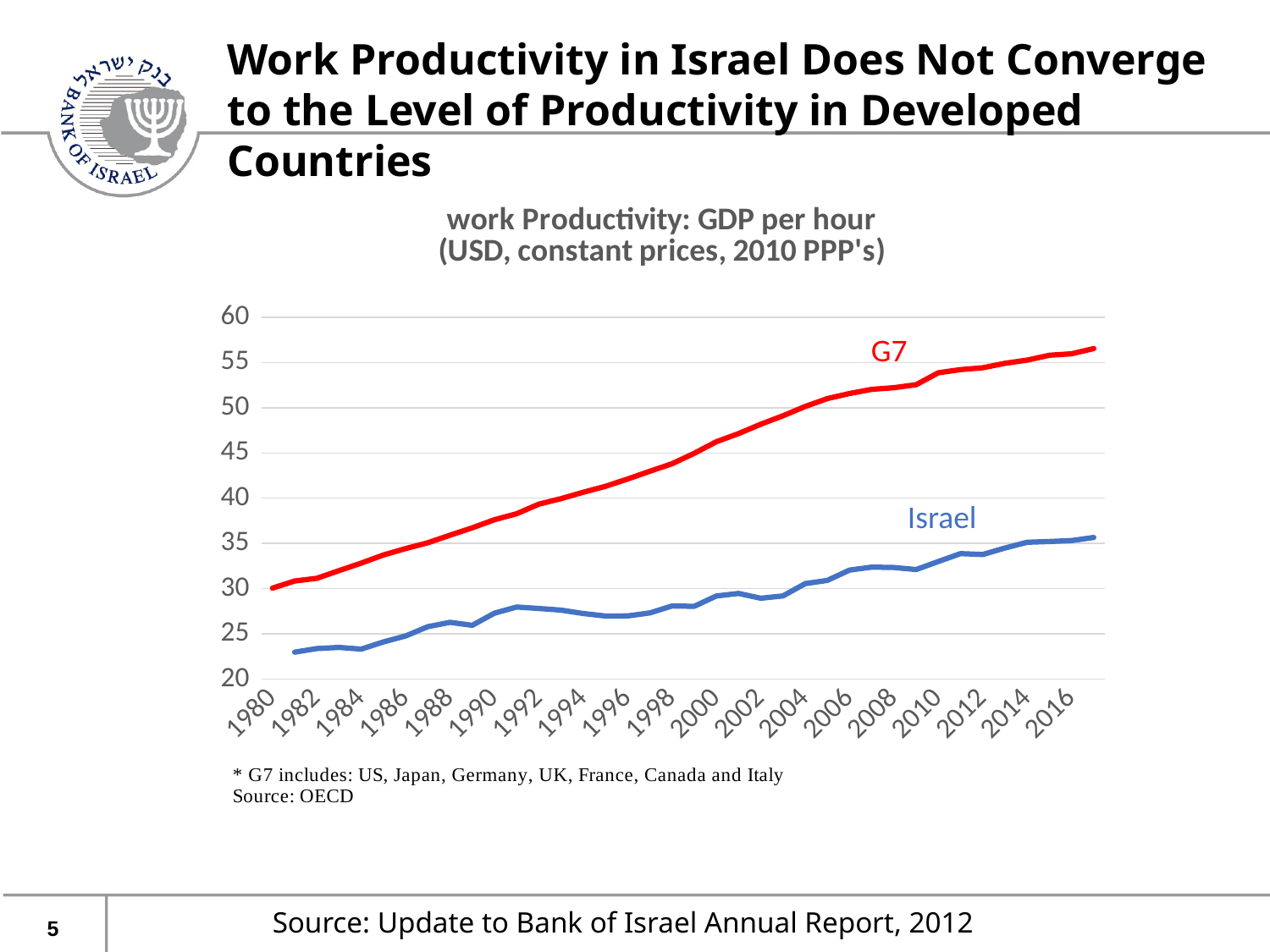
Does the Israel line generally rise or fall from 1980 to 2016? rise Is the value for Israel in 2000 greater or less than 30? less What kind of chart is shown on the slide? line chart Does the G7 line rise or fall from 1980 to 2016? rise Is the value for G7 in 2010 greater or less than 50? greater What colour is the line for Israel? blue Is the value for G7 in 1990 greater or less than 35? greater How many series are plotted on the chart? 2 Which two series are plotted on the chart? G7 and Israel In 2016, which series has the higher value, G7 or Israel? G7